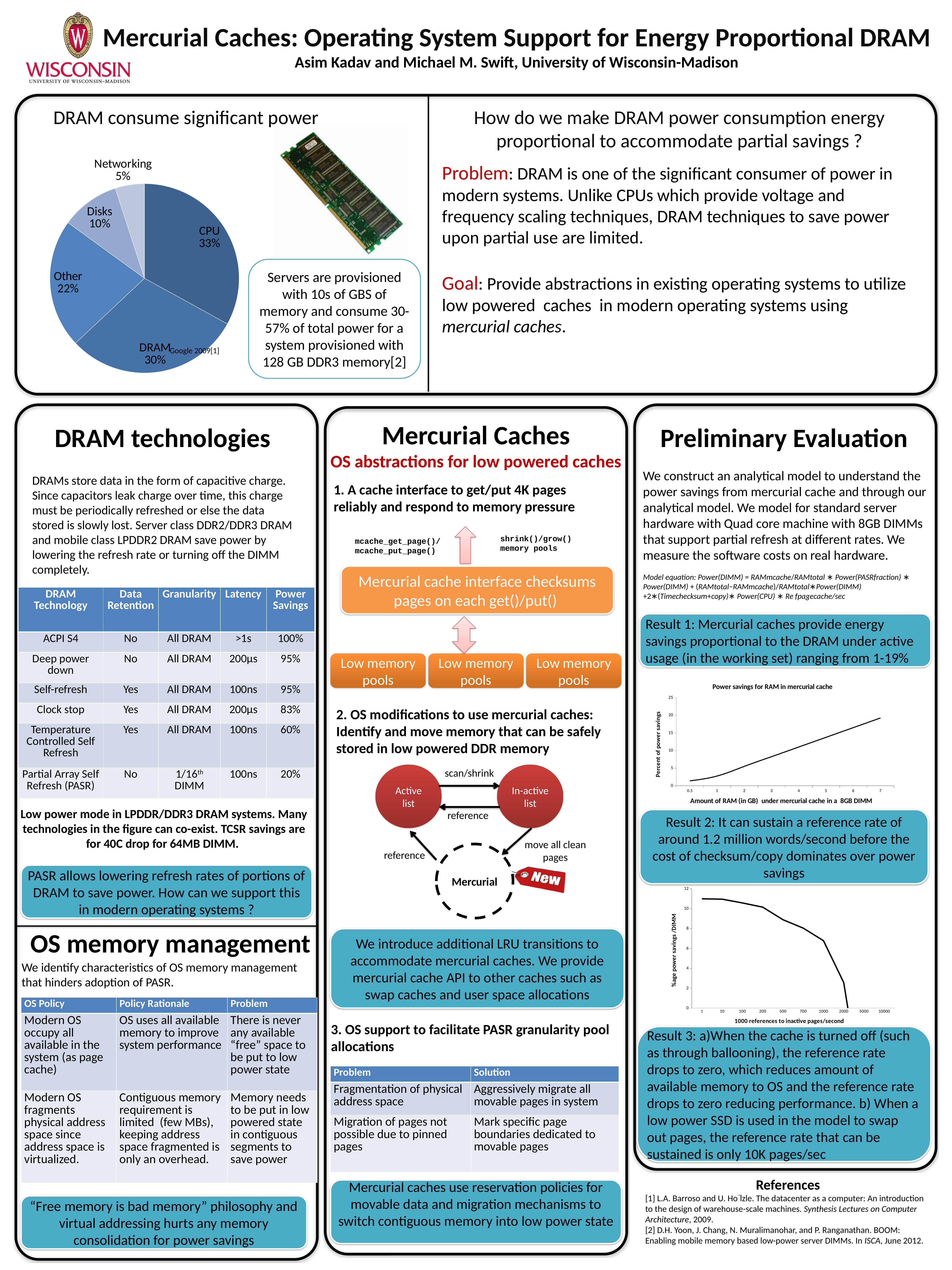
What kind of chart is shown under 'DRAM consume significant power'? Pie chart In the pie chart under 'DRAM consume significant power', what share of power does DRAM consume? 30% In the pie chart under 'DRAM consume significant power', what share of power does CPU consume? 33% In the pie chart under 'DRAM consume significant power', which category has the largest share? CPU In the chart titled 'Power savings for RAM in mercurial cache', is the percent of power savings at 7 GB greater or less than 20? less In the chart titled 'Power savings for RAM in mercurial cache', do the values rise or fall as the amount of RAM increases? Rise In the pie chart under 'DRAM consume significant power', which category has the smallest share? Networking In the chart with x axis '1000 references to inactive pages/second', is the %age power savings/DIMM at 1 greater or less than 10? greater In the pie chart under 'DRAM consume significant power', what is the difference between the CPU share and the Disks share? 23% How many slices does the pie chart under 'DRAM consume significant power' have? 5 In the chart with x axis '1000 references to inactive pages/second', do the values rise or fall as the reference rate increases? Fall In the pie chart under 'DRAM consume significant power', which is larger, the Other share or the Disks share? Other